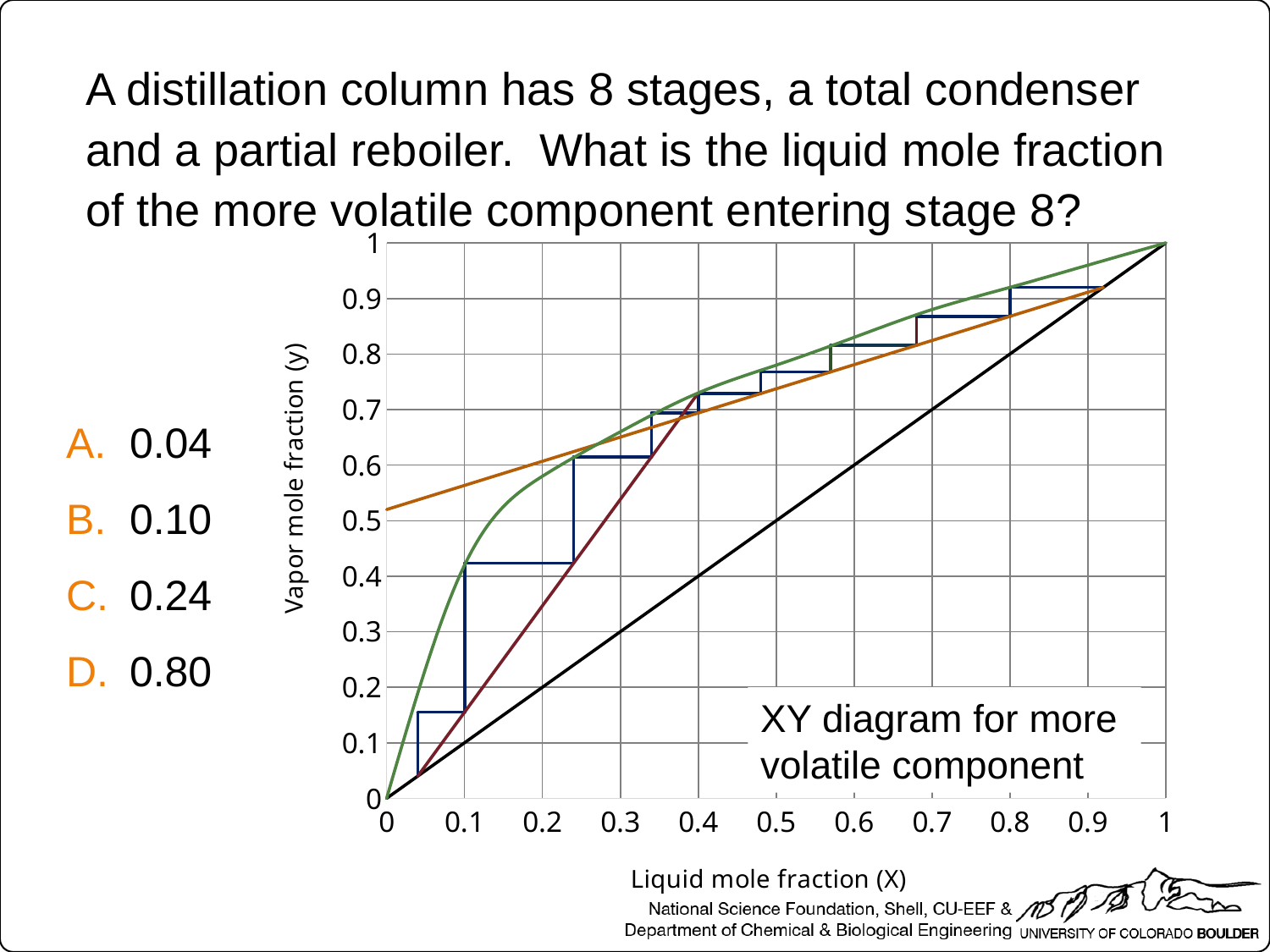
What is the title text shown inside the chart area? XY diagram for more volatile component Is the value of the orange line at a liquid mole fraction of 0 greater or less than 0.6? less Is the value of the green curve at a liquid mole fraction of 0.2 greater or less than 0.5? greater What is the vapor mole fraction of the black diagonal line at a liquid mole fraction of 1? 1 What kind of chart is shown on the slide? line chart What is the label of the horizontal axis of the chart? Liquid mole fraction (X) At a liquid mole fraction of 0.2, which is larger: the green curve or the black diagonal line? the green curve Is the value of the green curve at a liquid mole fraction of 0.1 greater or less than 0.2? greater What is the highest value shown on the vertical axis of the chart? 1 Does the green equilibrium curve rise or fall as the liquid mole fraction increases from 0 to 1? rise What is the vapor mole fraction of the black diagonal line at a liquid mole fraction of 0.5? 0.5